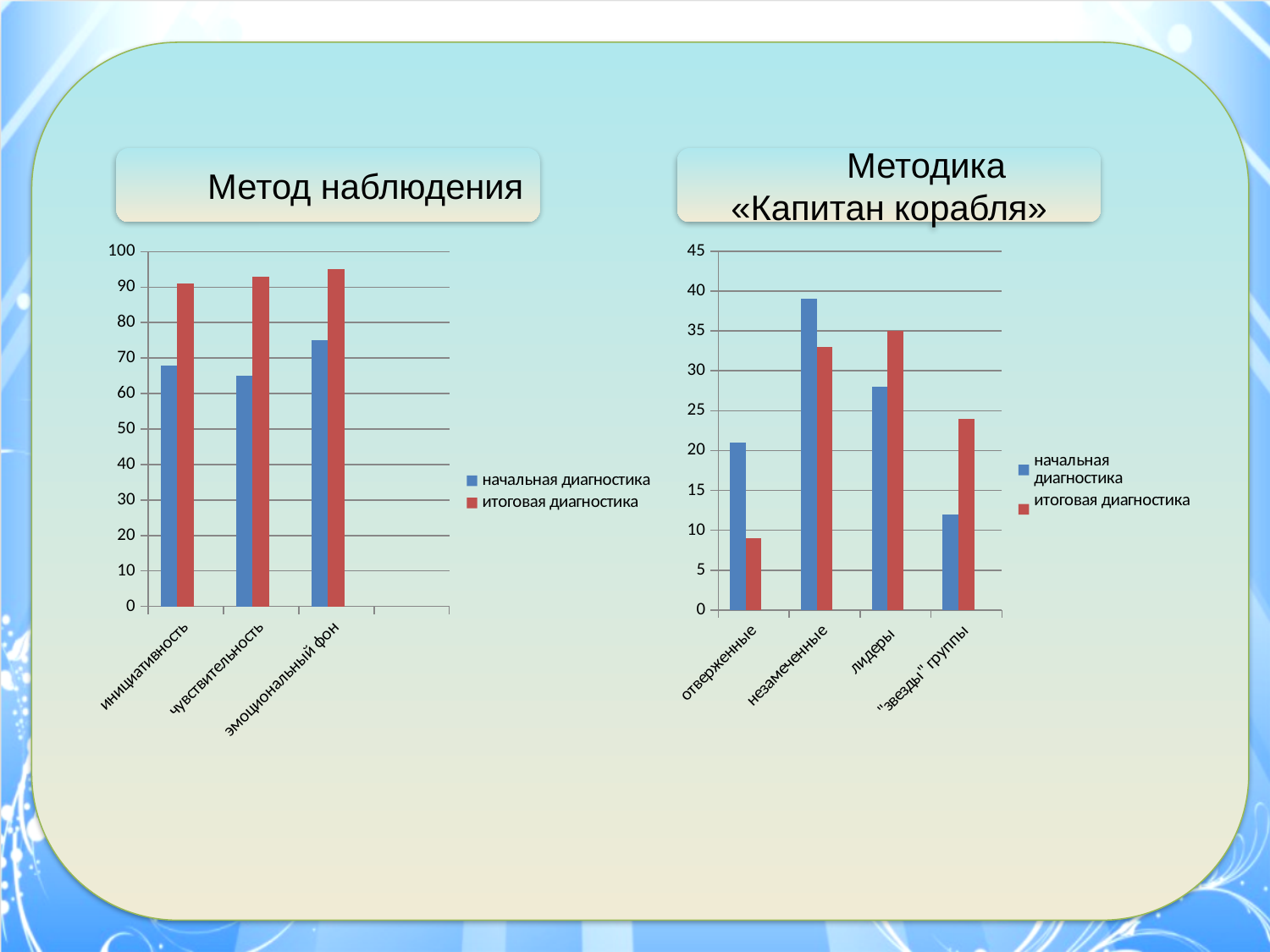
In the left chart «Метод наблюдения», is the value of итоговая диагностика for эмоциональный фон greater or less than 90? greater In the right chart «Методика «Капитан корабля»», for отверженные, which series has the larger value: начальная диагностика or итоговая диагностика? начальная диагностика In the left chart «Метод наблюдения», how many series does the legend list? 2 In the right chart «Методика «Капитан корабля»», which category has the highest value for начальная диагностика? незамеченные In the left chart «Метод наблюдения», which category has the highest value for начальная диагностика? эмоциональный фон In the right chart «Методика «Капитан корабля»», which category has the lowest value for итоговая диагностика? отверженные In the left chart «Метод наблюдения», is the value of начальная диагностика for инициативность greater or less than 60? greater In the right chart «Методика «Капитан корабля»», how many categories are shown on the x axis? 4 In the left chart «Метод наблюдения», how many categories are shown on the x axis? 3 In the left chart «Метод наблюдения», for чувствительность, which series has the larger value: начальная диагностика or итоговая диагностика? итоговая диагностика What kind of chart is the left chart titled «Метод наблюдения»? bar chart In the right chart «Методика «Капитан корабля»», is the value of начальная диагностика for незамеченные greater or less than 35? greater